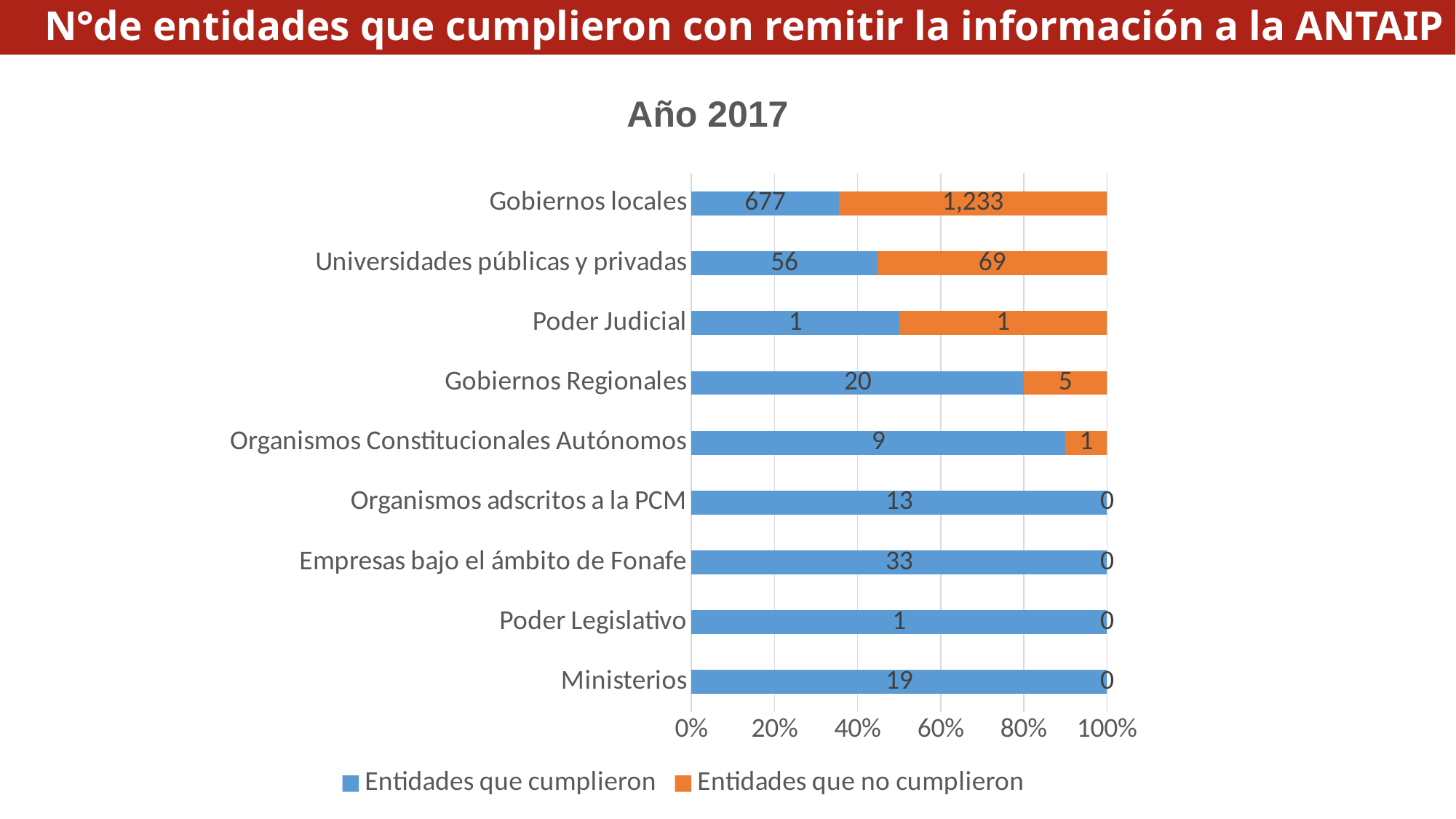
How many 'Entidades que cumplieron' are shown for Gobiernos locales? 677 For Universidades públicas y privadas, which is larger: 'Entidades que cumplieron' or 'Entidades que no cumplieron'? Entidades que no cumplieron How many categories (entity types) are listed on the chart? 9 What is the total number of entities (cumplieron plus no cumplieron) for Universidades públicas y privadas? 125 Which category has the highest number of 'Entidades que no cumplieron'? Gobiernos locales What is the title shown above the chart? Año 2017 How many 'Entidades que cumplieron' are shown for Empresas bajo el ámbito de Fonafe? 33 Is the share of 'Entidades que cumplieron' for Gobiernos locales greater or less than 40%? less What is the difference between 'Entidades que no cumplieron' and 'Entidades que cumplieron' for Gobiernos locales? 556 How many 'Entidades que no cumplieron' are shown for Gobiernos locales? 1,233 How many series does the legend list? 2 What type of chart is shown on the slide? Stacked bar chart